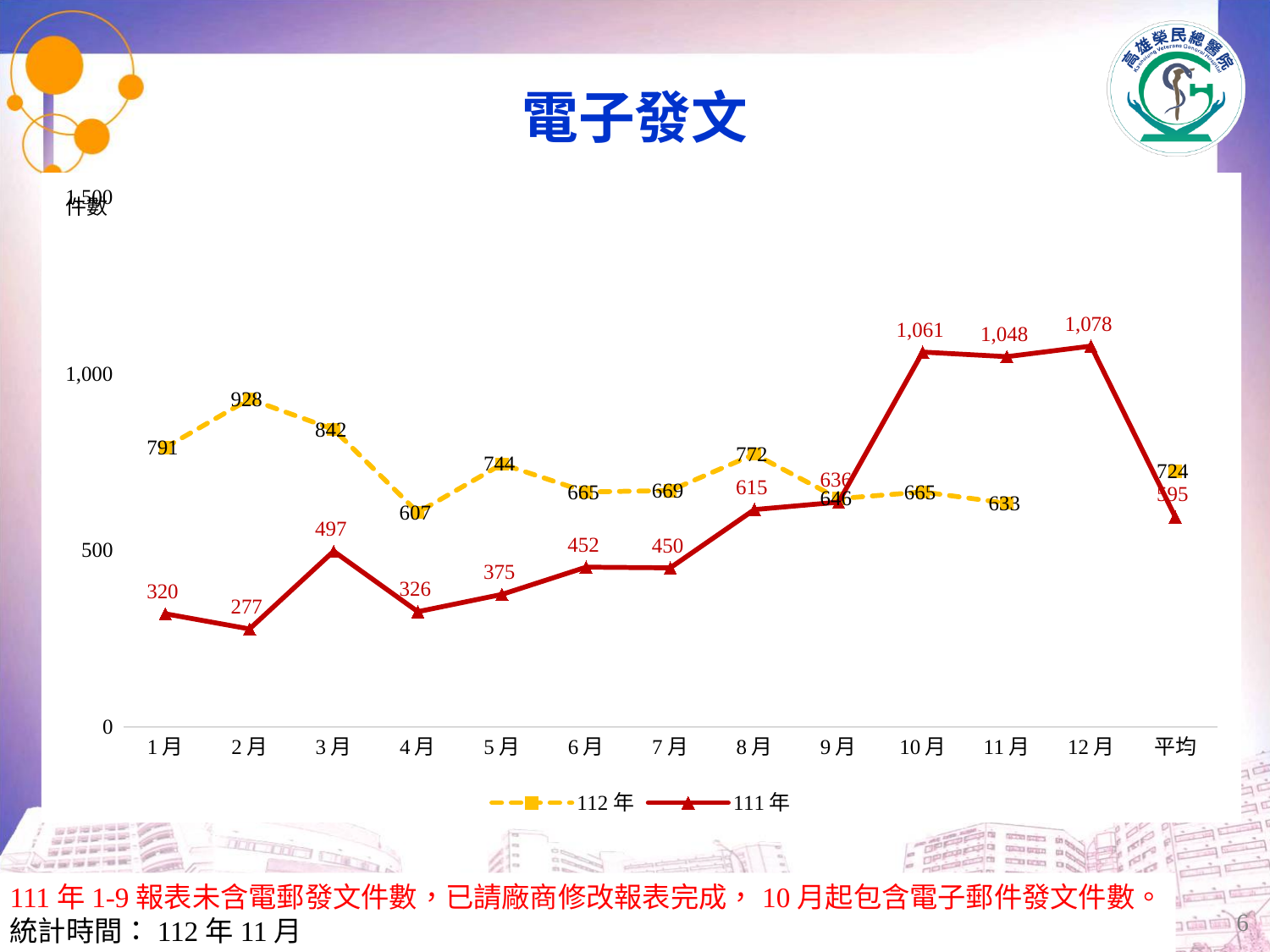
What is the value for 112年 in 2月? 928 What is the title of the chart? 電子發文 How many series does the legend list? 2 What kind of chart is shown on the slide? line chart What is the 平均 value for the 112年 series? 724 In 10月, which series has the larger value, 111年 or 112年? 111年 What is the difference between the 112年 and 111年 values in 1月? 471 In which month is the 111年 series highest? 12月 Is the value for 111年 in 10月 greater or less than 1,000? greater What is the value for 111年 in 12月? 1,078 In which month is the 112年 series highest? 2月 In which month is the 111年 series lowest? 2月